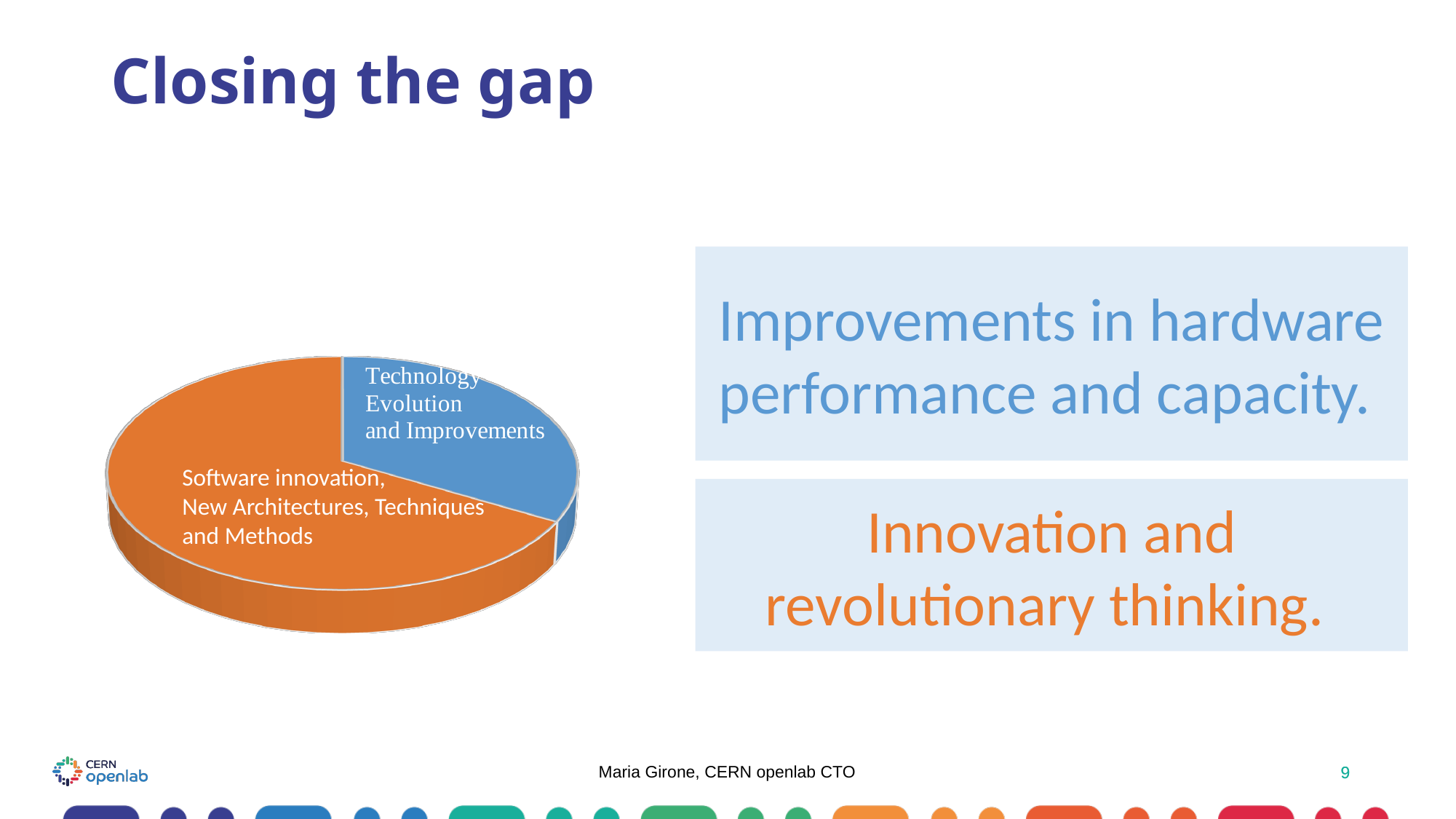
How many slices does the pie chart have? 2 Which slice of the pie chart is the largest? Software innovation, New Architectures, Techniques and Methods Which slice of the pie chart is the smallest? Technology Evolution and Improvements What colour is the Technology Evolution and Improvements slice? blue Which slice is larger: Technology Evolution and Improvements or Software innovation, New Architectures, Techniques and Methods? Software innovation, New Architectures, Techniques and Methods What colour is the Software innovation, New Architectures, Techniques and Methods slice? orange What kind of chart is shown on the slide? pie chart